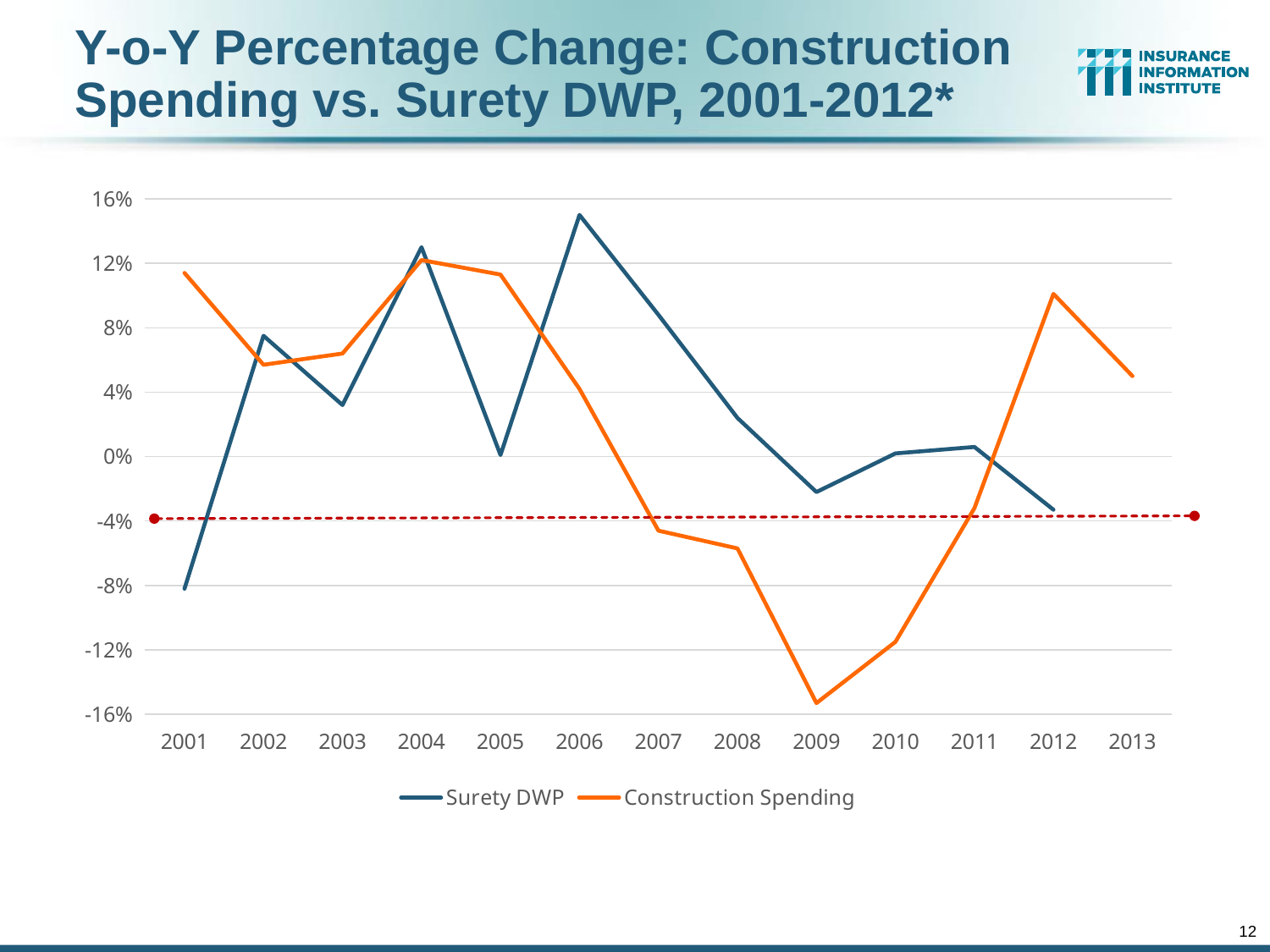
How many years are shown on the x axis? 13 In which year does the Surety DWP series reach its highest value? 2006 Is the Surety DWP value for 2001 greater or less than -4%? less How many series does the legend list? 2 Is the Surety DWP value for 2006 greater or less than 12%? greater What kind of chart is shown on the slide? Line chart Is the Construction Spending value for 2009 greater or less than -12%? less In which year does the Construction Spending series reach its lowest value? 2009 Does the Construction Spending series rise or fall from 2009 to 2012? Rise In 2009, which series has the higher value, Surety DWP or Construction Spending? Surety DWP In which year does the Surety DWP series reach its lowest value? 2001 In 2001, which series has the higher value, Surety DWP or Construction Spending? Construction Spending